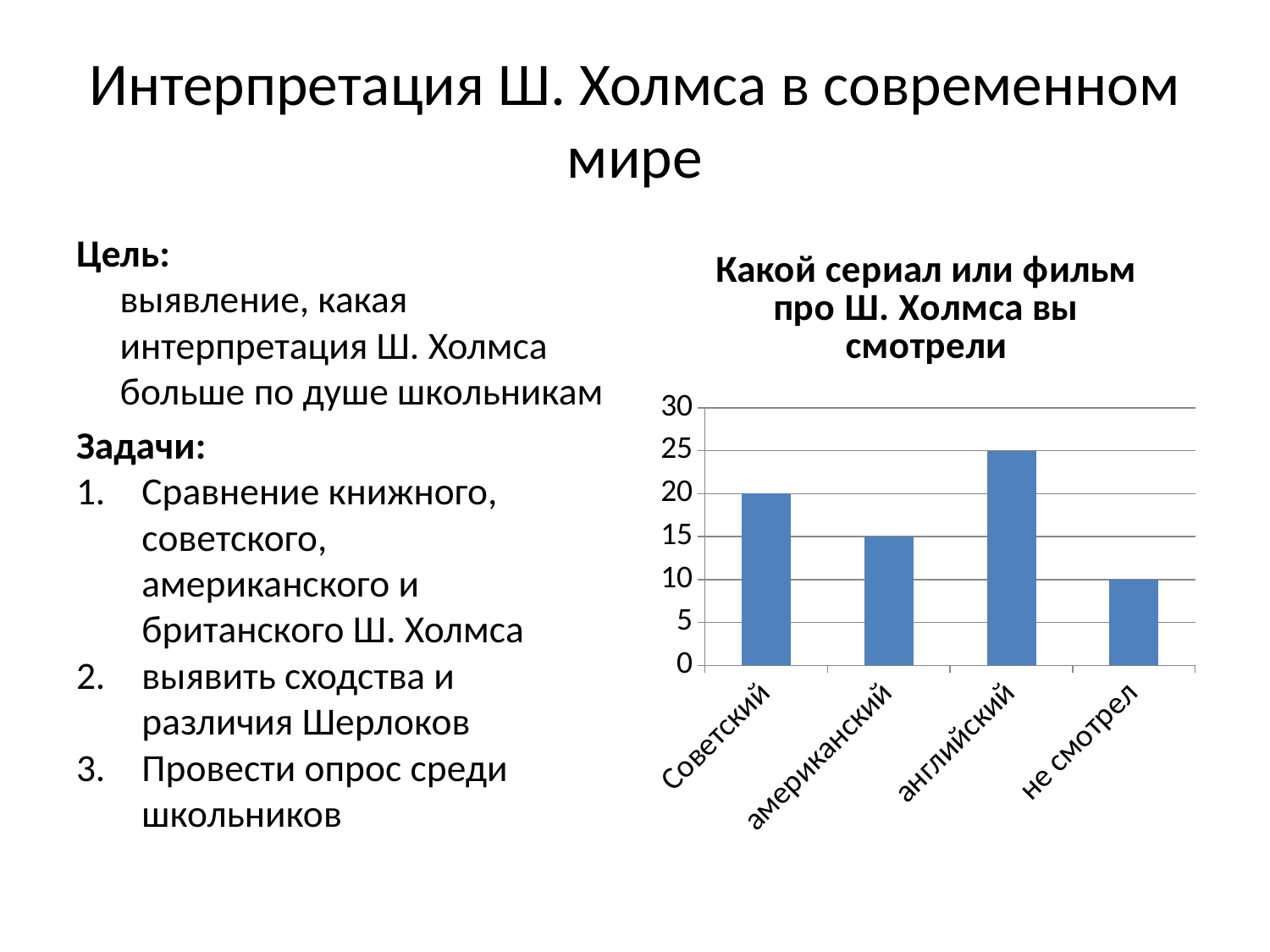
Which category has the highest value? английский What is the value for не смотрел? 10 What is the value for американский? 15 What is the value for Советский? 20 What type of chart is shown on the slide? bar chart Which is larger, the value for Советский or the value for американский? Советский Is the value for не смотрел greater or less than 15? less What is the title of the chart? Какой сериал или фильм про Ш. Холмса вы смотрели How many categories are shown on the x axis of the chart? 4 Which category has the lowest value? не смотрел What is the difference between the values for английский and американский? 10 What is the value for английский? 25